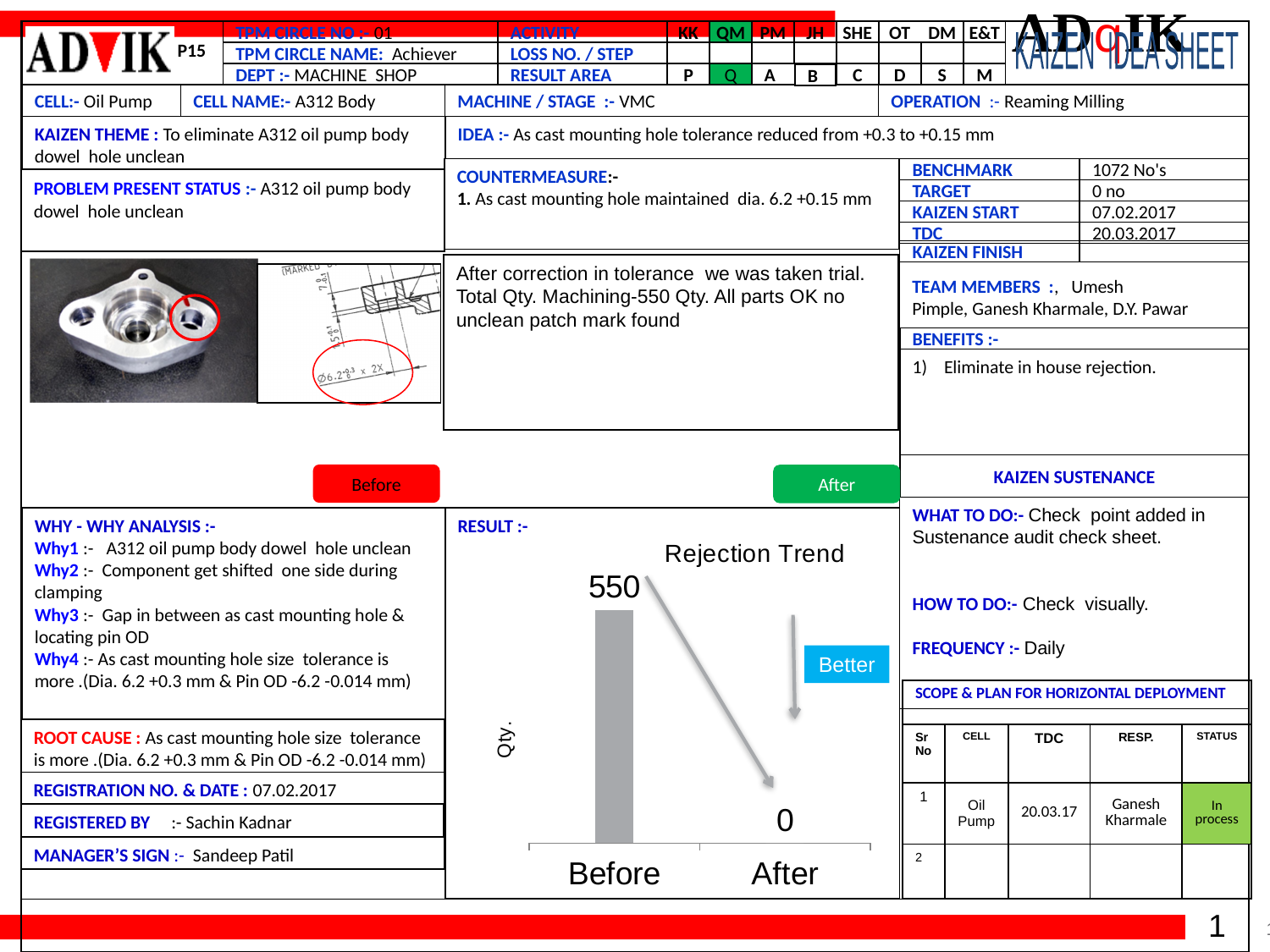
What is the label on the vertical axis of the Rejection Trend chart? Qty. How many categories are shown on the x axis of the Rejection Trend chart? 2 Which category in the Rejection Trend chart has the highest value? Before What kind of chart is the Rejection Trend chart? bar chart What is the title of the chart on the slide? Rejection Trend Which category in the Rejection Trend chart has the lowest value? After In the Rejection Trend chart, what is the difference between the Before and After values? 550 Do the values in the Rejection Trend chart rise or fall from Before to After? fall In the Rejection Trend chart, what is the value for Before? 550 In the Rejection Trend chart, is the value for Before larger or smaller than the value for After? larger In the Rejection Trend chart, what is the value for After? 0